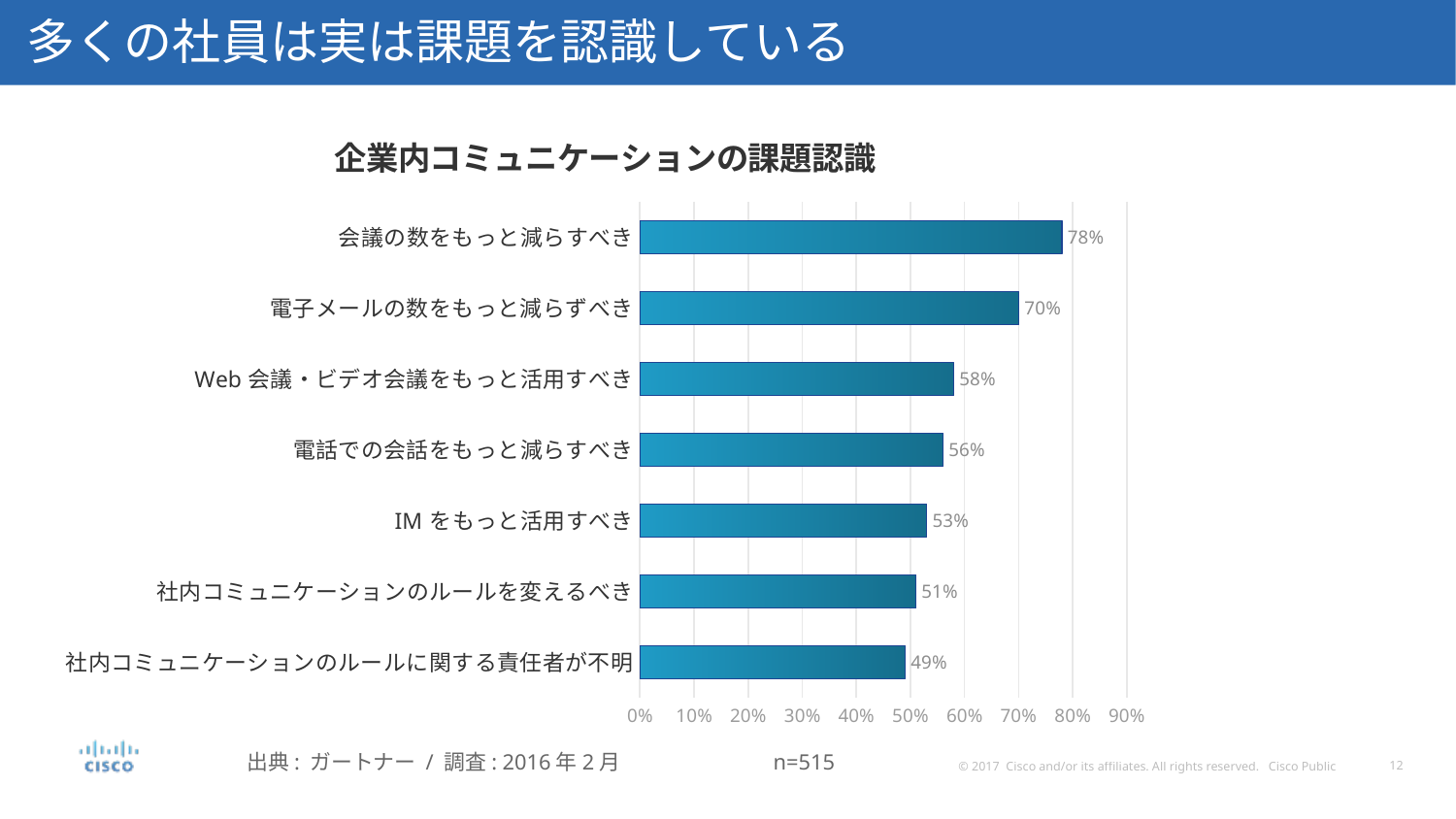
Which is larger, the value for Web 会議・ビデオ会議をもっと活用すべき or the value for 電話での会話をもっと減らすべき? Web 会議・ビデオ会議をもっと活用すべき How many categories are shown in the chart? 7 What is the value for IM をもっと活用すべき? 53% Which category has the highest value? 会議の数をもっと減らすべき What is the title of the chart? 企業内コミュニケーションの課題認識 What is the value for 会議の数をもっと減らすべき? 78% Which category has the lowest value? 社内コミュニケーションのルールに関する責任者が不明 What kind of chart is shown on the slide? bar chart What is the value for 社内コミュニケーションのルールに関する責任者が不明? 49% What is the value for 電子メールの数をもっと減らずべき? 70% Is the value for 社内コミュニケーションのルールを変えるべき greater or less than 60%? less What is the difference between the values for 会議の数をもっと減らすべき and 電子メールの数をもっと減らずべき? 8%